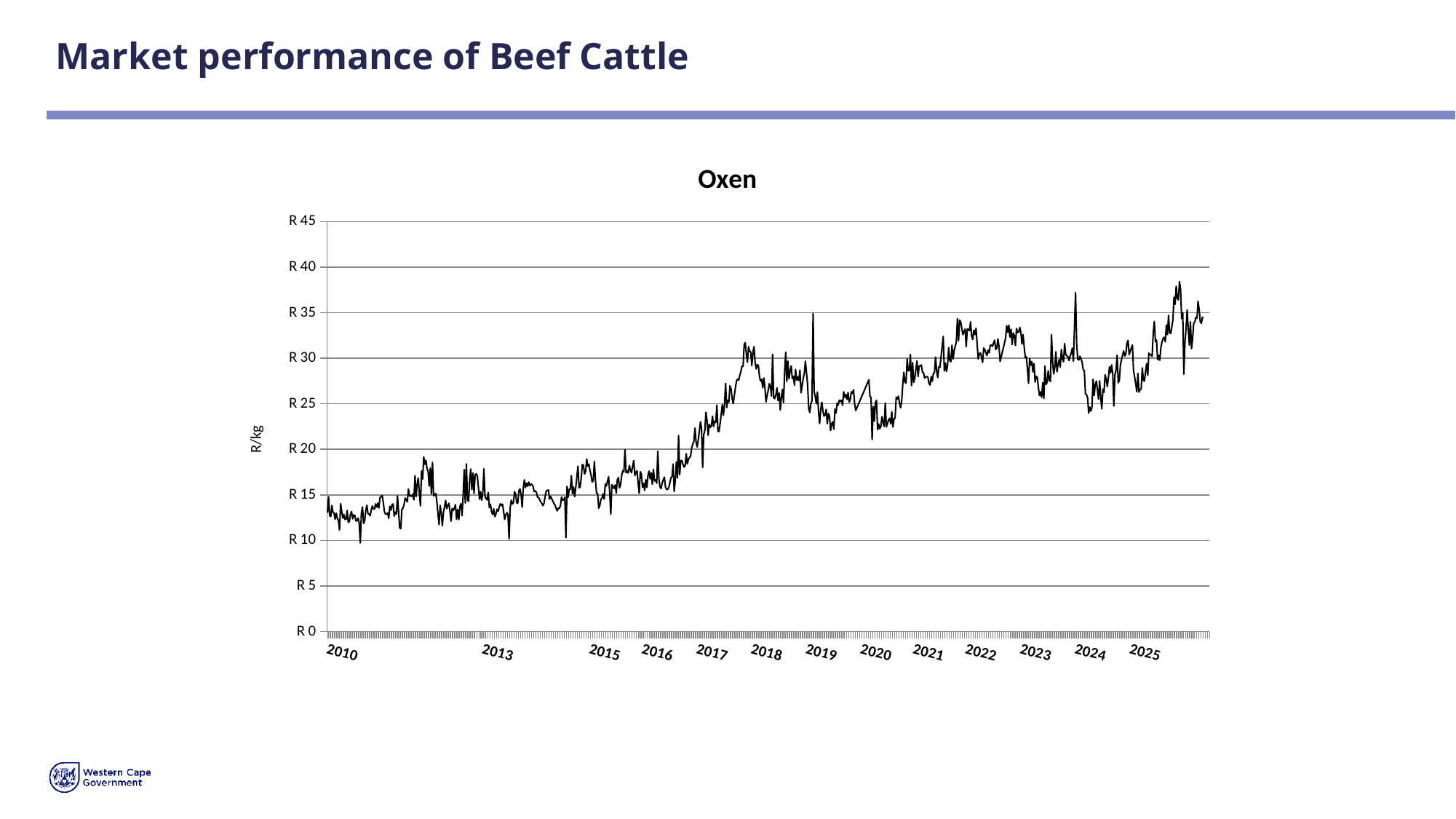
Is the oxen price during 2013 greater or less than R 20? less Is the highest oxen price reached in 2025 greater or less than R 30? greater Is the oxen price during 2015 greater or less than R 25? less Which period has higher oxen prices, 2010 or 2024? 2024 Overall, do the oxen prices rise or fall from 2010 to 2025? Rise What is the title of the chart? Oxen What kind of chart is shown on the slide? Line chart What is the label on the vertical axis of the chart? R/kg How many data series (lines) are plotted on the chart? 1